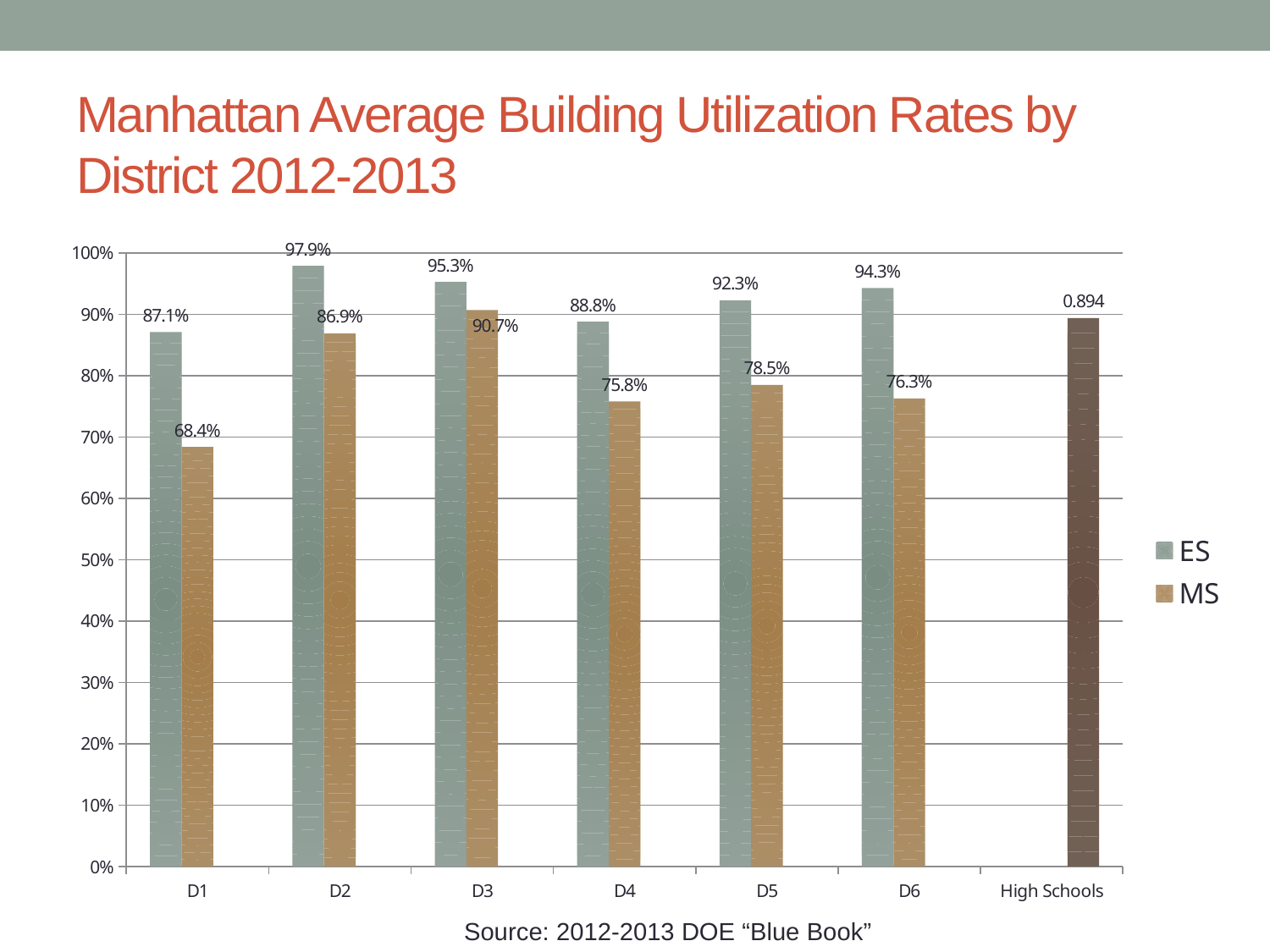
What kind of chart is shown on the slide? bar chart What is the difference between the ES and MS values for D1? 18.7% How many categories are shown on the x axis? 7 What is the ES value for D2? 97.9% Which district has the highest ES value? D2 Is the MS value for D4 greater or less than 80%? less How many series does the legend list? 2 Which district has the lowest MS value? D1 What is the MS value for D1? 68.4% What is the MS value for D3? 90.7% Which is larger, the MS value for D5 or the MS value for D6? D5 What value is labeled on the High Schools bar? 0.894